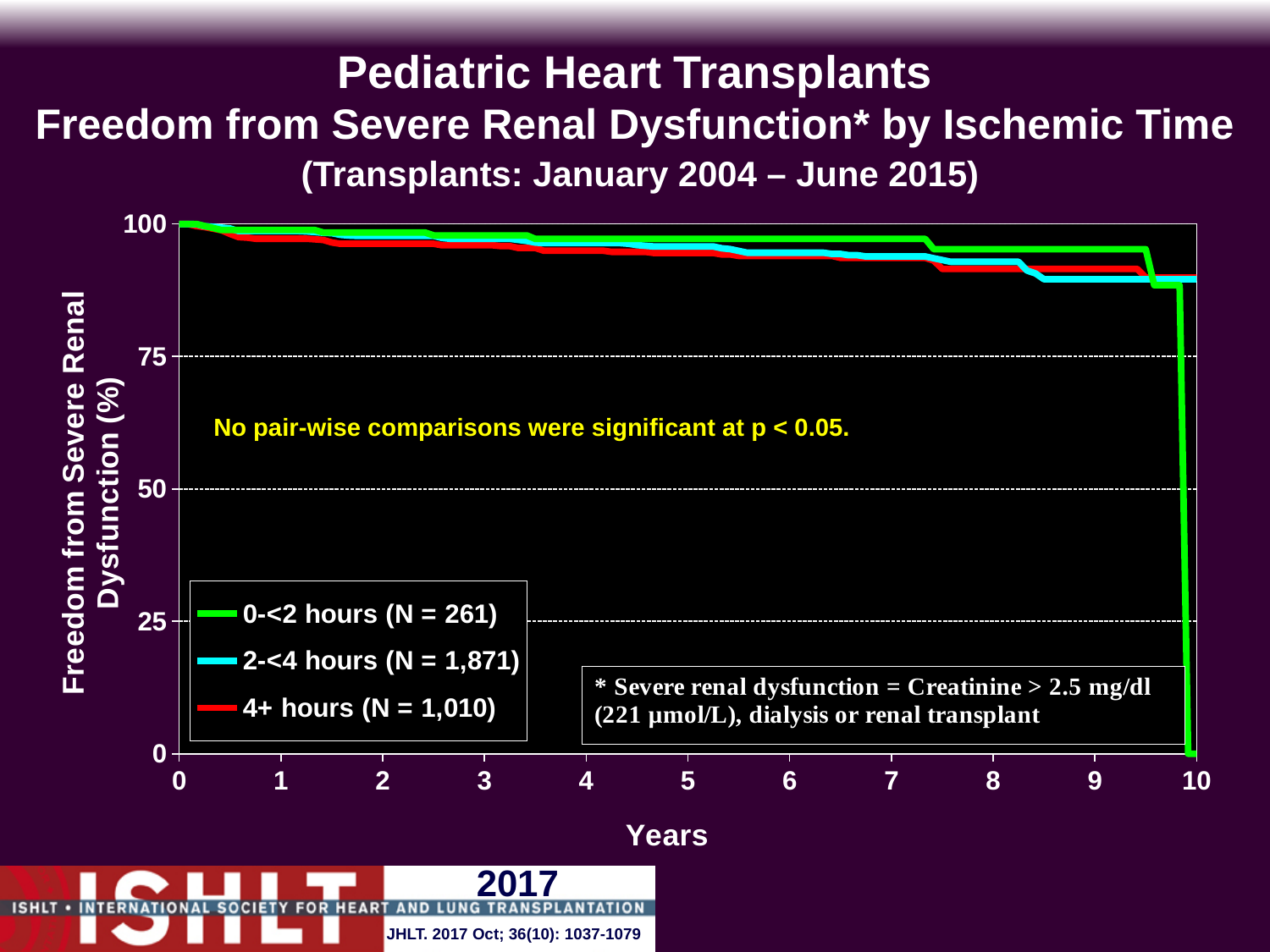
Is the value for the 4+ hours group at 3 years greater or less than 50? greater Is the value for the 0-<2 hours group at 5 years greater or less than 75? greater Do the freedom from severe renal dysfunction values rise or fall as years increase? fall What is the label of the x axis? Years What is the highest value shown on the y axis? 100 Is the value for the 2-<4 hours group at 9 years greater or less than 75? greater What kind of chart is shown on the slide? line chart What is the N shown in the legend for the 4+ hours group? 1,010 How many series does the legend list? 3 Which ischemic time group has N = 1,871 in the legend? 2-<4 hours How many tick marks are labeled on the x axis? 11